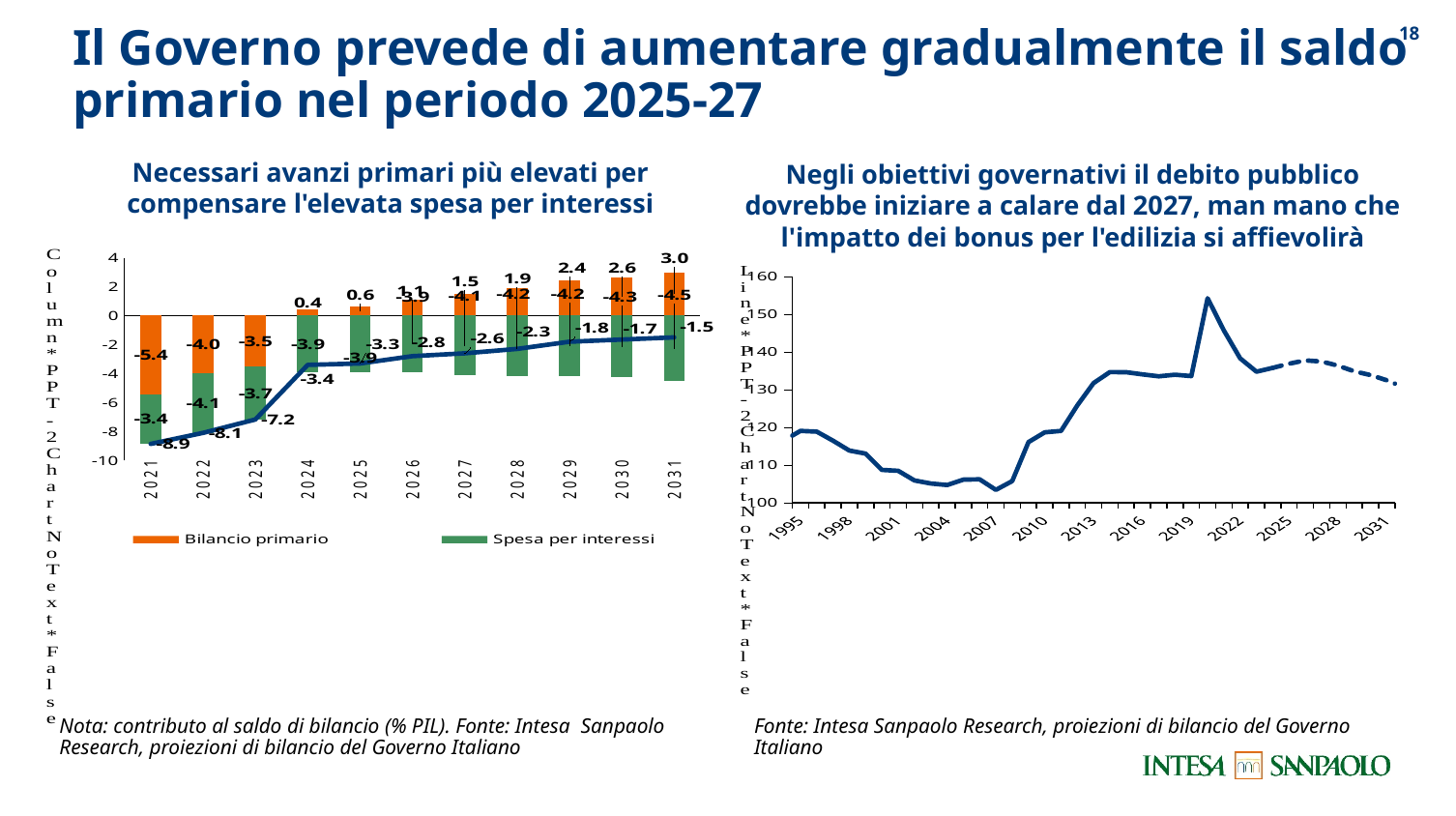
In the left chart, what is the value of Spesa per interessi for 2031? -4.5 In the left chart, how many series does the legend list? 2 In the left chart, how many years are shown on the x axis? 11 In the right chart, is the value for 2007 greater or less than 110? less In the left chart, what is the value of Bilancio primario for 2031? 3.0 In the right chart, is the value for 2020 greater or less than 150? greater In the left chart, what is the value of Bilancio primario for 2021? -5.4 In the left chart, what is the value of Spesa per interessi for 2022? -4.1 In the left chart, does the Bilancio primario value rise or fall from 2021 to 2031? rise In the left chart, which year has the lowest Bilancio primario value? 2021 In the left chart, what is the difference between the Bilancio primario values for 2031 and 2030? 0.4 In the left chart, which year has the highest Bilancio primario value? 2031